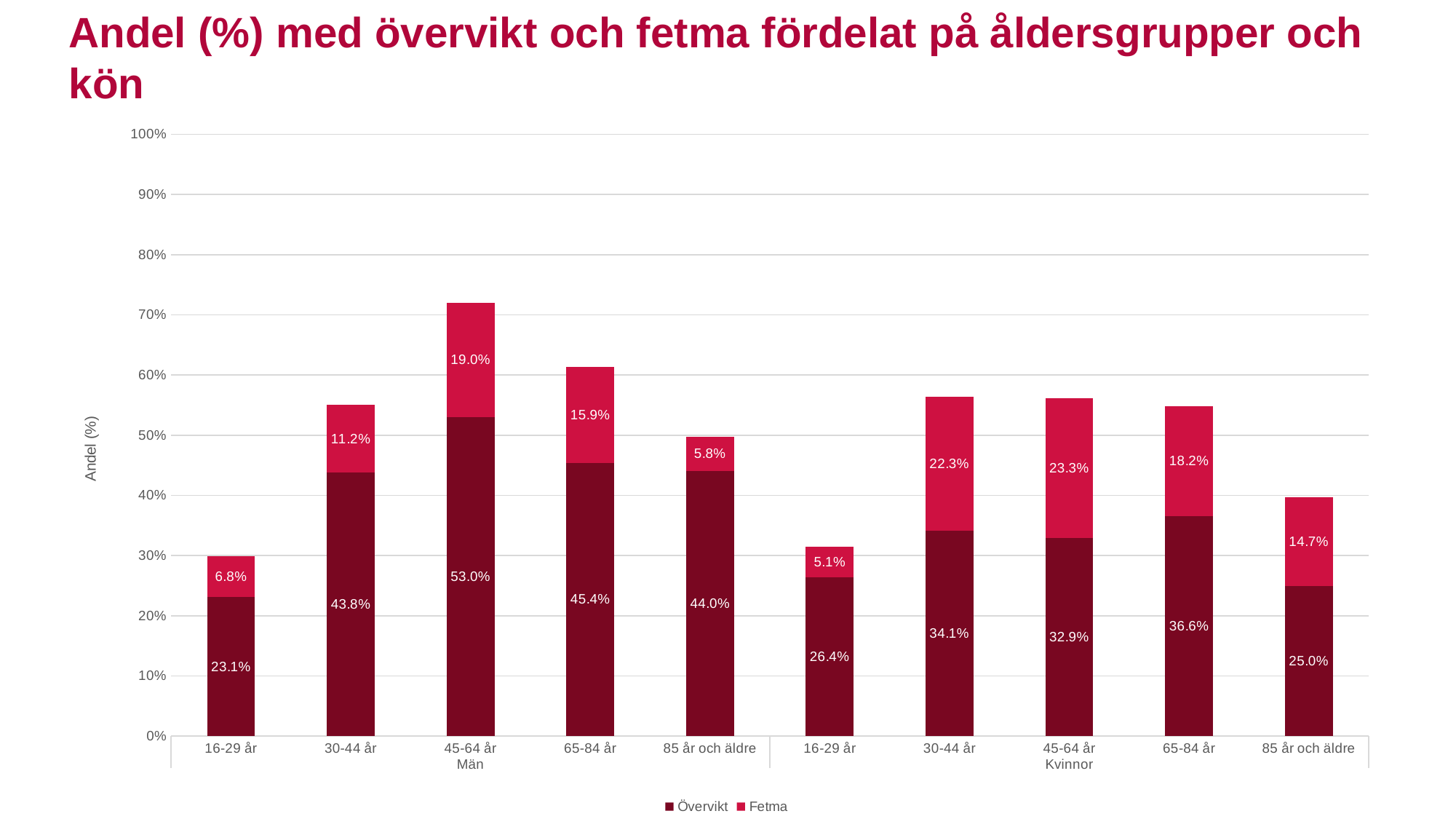
Which age group and sex has the lowest Fetma value? Kvinnor 16-29 år How many series does the legend list? 2 What is the Fetma value for Kvinnor aged 30-44 år? 22.3% What is the difference between the Fetma value for Kvinnor 45-64 år and Män 45-64 år? 4.3 percentage points What is the Fetma value for Män aged 85 år och äldre? 5.8% Which age group and sex has the highest Övervikt value? Män 45-64 år What is the total of the stacked bar for Män 45-64 år? 72.0% Which has the larger Övervikt value: Män 65-84 år or Kvinnor 65-84 år? Män 65-84 år How many stacked bars are shown in the chart? 10 What kind of chart is shown on the slide? Stacked bar chart Is the total stacked value for Kvinnor 30-44 år greater or less than 50%? greater What is the Övervikt value for Män aged 45-64 år? 53.0%